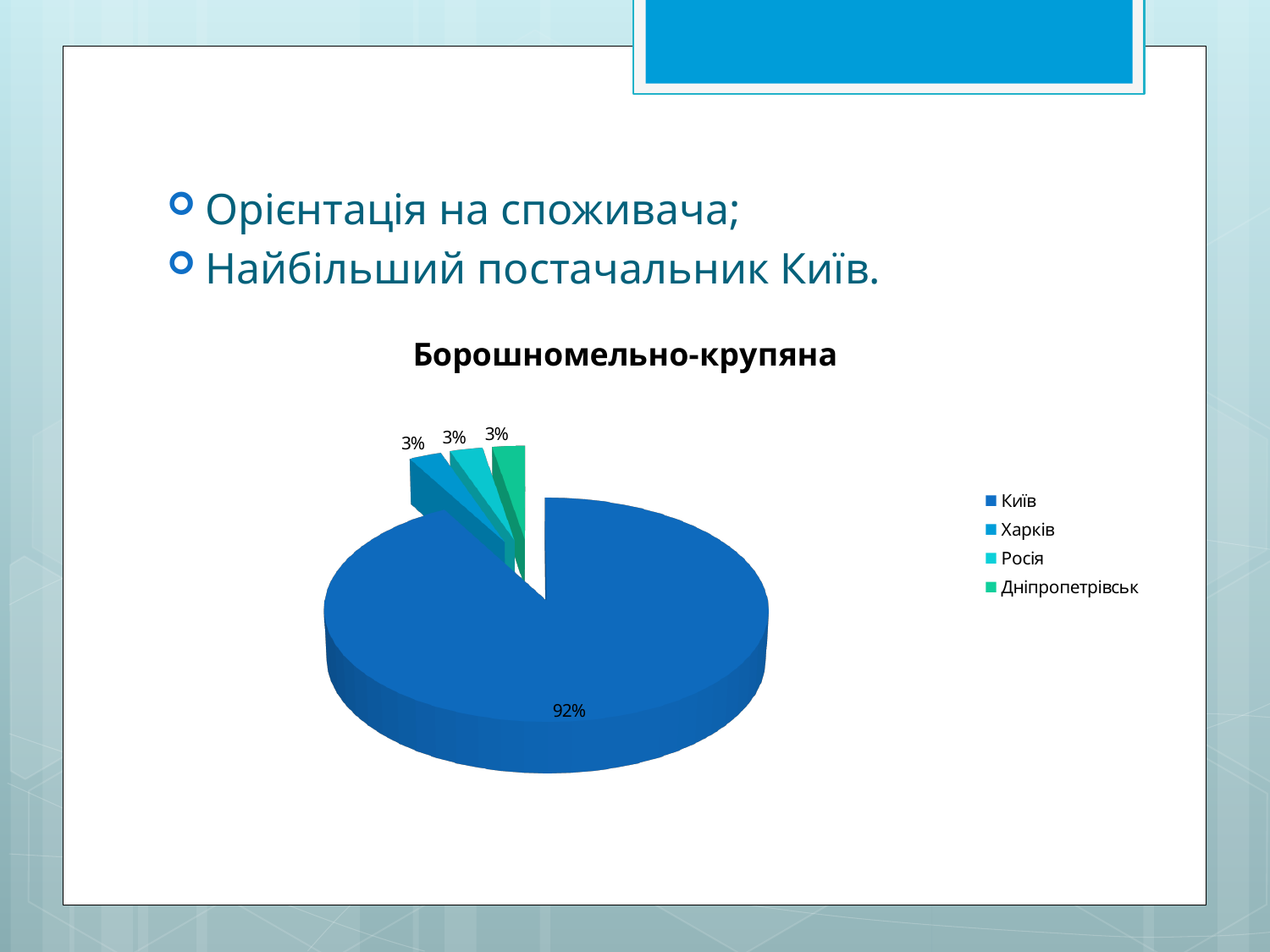
What is the title of the chart on the slide? Борошномельно-крупяна How many categories are shown in the pie chart? 4 How many entries does the legend of the pie chart list? 4 Which is larger in the pie chart, the slice for Київ or the slice for Росія? Київ What is the value shown for Харків in the pie chart? 3% What is the value shown for Дніпропетровськ in the pie chart? 3% Which legend entry is listed last in the pie chart's legend? Дніпропетрівськ Which category has the largest slice of the pie chart? Київ What type of chart is shown on the slide? Pie chart By how many percentage points does the Київ slice exceed the Харків slice? 89 percentage points What is the value shown for Росія in the pie chart? 3% What share of the pie does Київ hold in the Борошномельно-крупяна chart? 92%